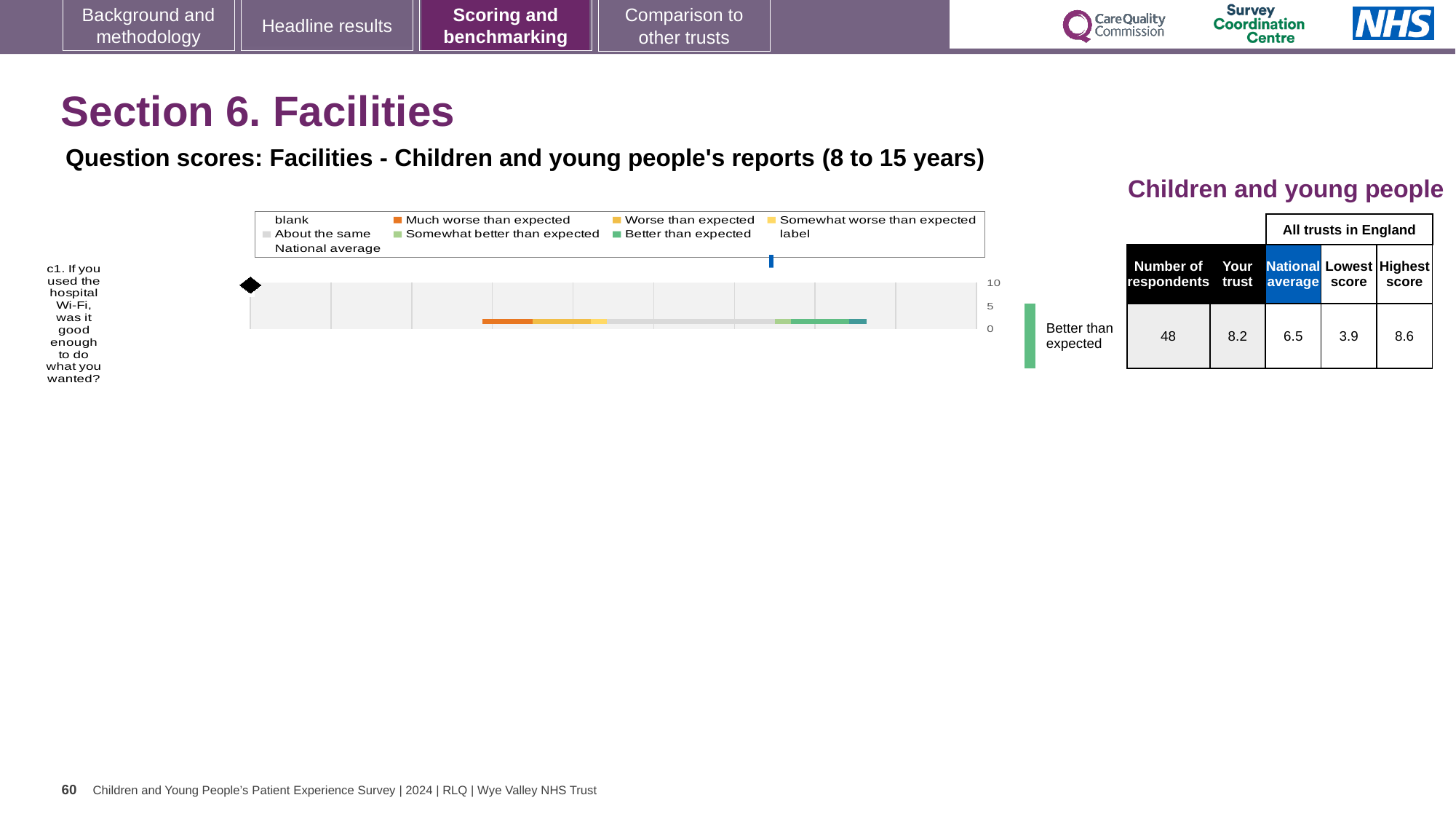
What is the highest score among all trusts in England for question c1? 8.6 How many entries does the chart legend list? 9 How many respondents answered question c1 about hospital Wi-Fi? 48 What is the difference between the highest and lowest scores across all trusts in England for question c1? 4.7 How many survey questions are plotted in the chart? 1 What is the national average score for question c1 about hospital Wi-Fi? 6.5 What kind of chart is shown on the slide for question c1? bar chart What rating category is shown beside the chart for question c1? Better than expected What is the difference between the trust's score and the national average for question c1? 1.7 Which is larger for question c1: the trust's score or the national average? the trust's score What is the 'Your trust' score for question c1 about hospital Wi-Fi? 8.2 What is the lowest score among all trusts in England for question c1? 3.9